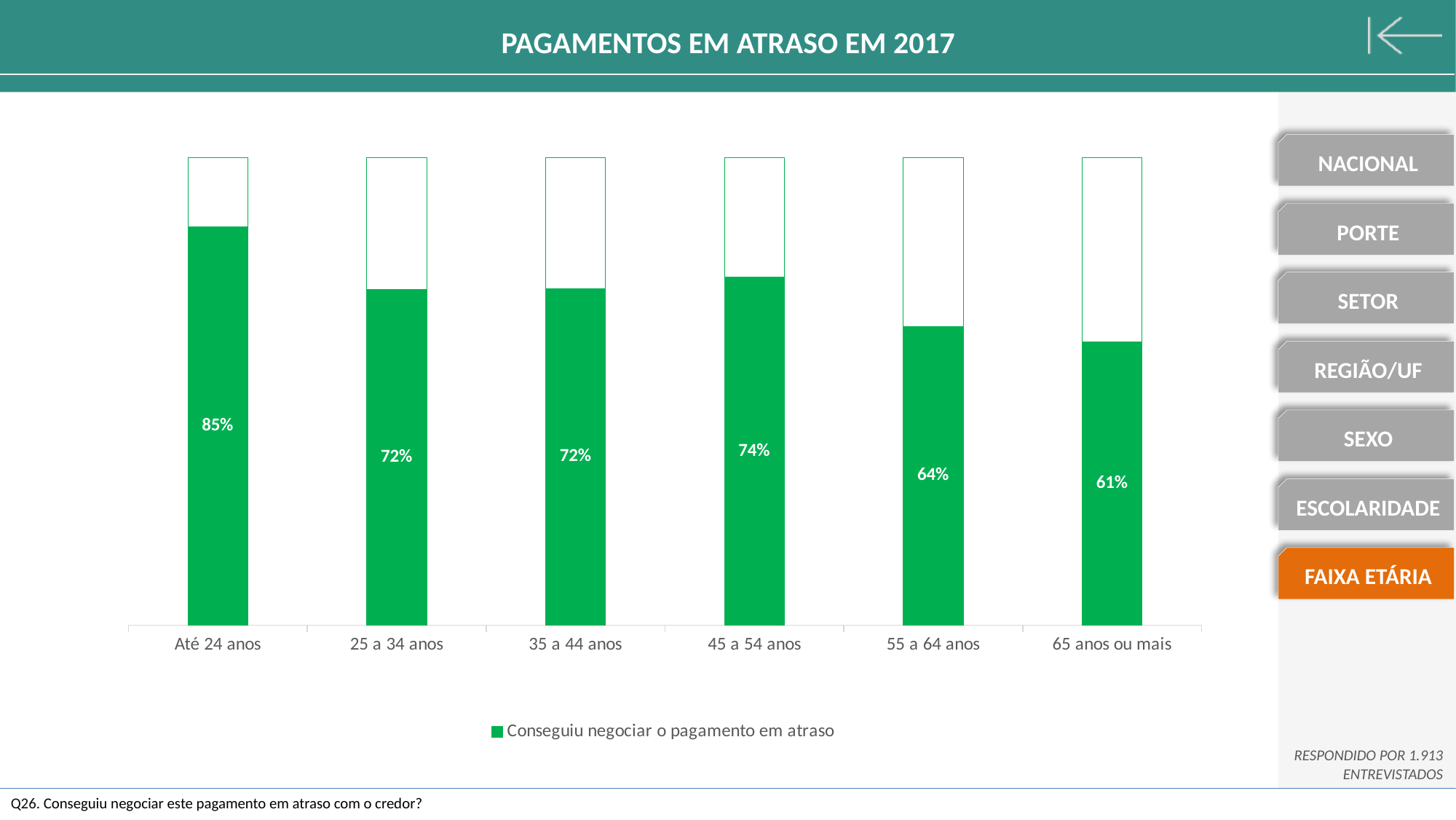
What is the value for '65 anos ou mais'? 61% What is the value for '55 a 64 anos'? 64% How many age groups are shown on the chart? 6 What is the value for '45 a 54 anos'? 74% What series does the legend list? Conseguiu negociar o pagamento em atraso What is the title of the slide? PAGAMENTOS EM ATRASO EM 2017 What is the difference between the values for 'Até 24 anos' and '65 anos ou mais'? 24% What is the value for 'Até 24 anos'? 85% Which age group has the lowest value? 65 anos ou mais Which is larger, the value for '45 a 54 anos' or the value for '55 a 64 anos'? 45 a 54 anos What kind of chart is shown on the slide? Bar chart Which age group has the highest value? Até 24 anos